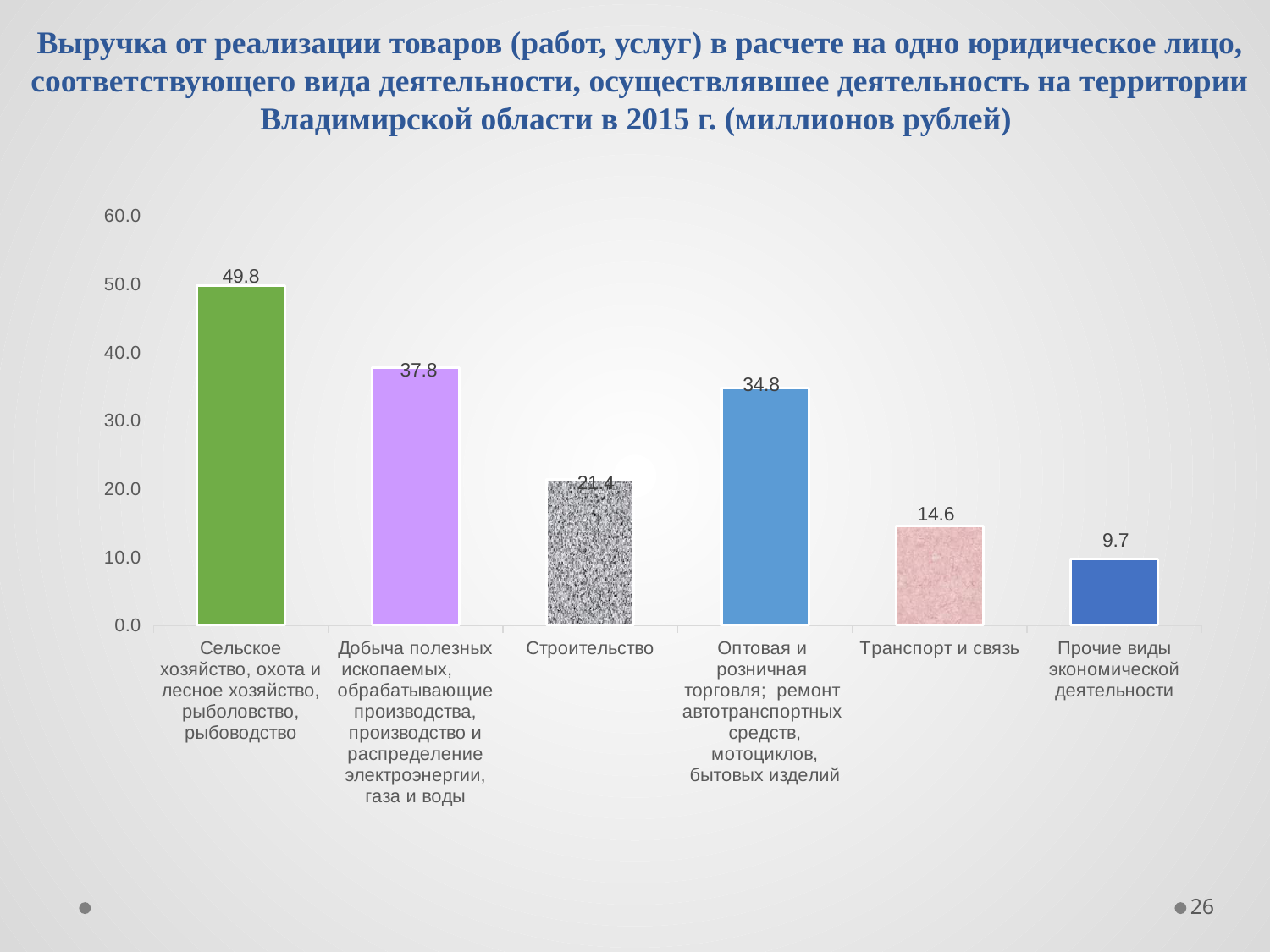
What kind of chart is shown on the slide? bar chart Which is larger: the value for Добыча полезных ископаемых, обрабатывающие производства, производство и распределение электроэнергии, газа и воды or the value for Оптовая и розничная торговля; ремонт автотранспортных средств, мотоциклов, бытовых изделий? Добыча полезных ископаемых, обрабатывающие производства, производство и распределение электроэнергии, газа и воды What is the highest value shown on the vertical axis? 60.0 What is the value for Транспорт и связь? 14.6 What is the value for Строительство? 21.4 What is the difference between the value for Добыча полезных ископаемых, обрабатывающие производства, производство и распределение электроэнергии, газа и воды and the value for Строительство? 16.4 What is the value for Прочие виды экономической деятельности? 9.7 How many categories are shown on the chart? 6 Which category has the lowest value? Прочие виды экономической деятельности Which category has the highest value? Сельское хозяйство, охота и лесное хозяйство, рыболовство, рыбоводство What is the difference between the value for Сельское хозяйство, охота и лесное хозяйство, рыболовство, рыбоводство and the value for Транспорт и связь? 35.2 Is the value for Строительство greater or less than 30.0? less